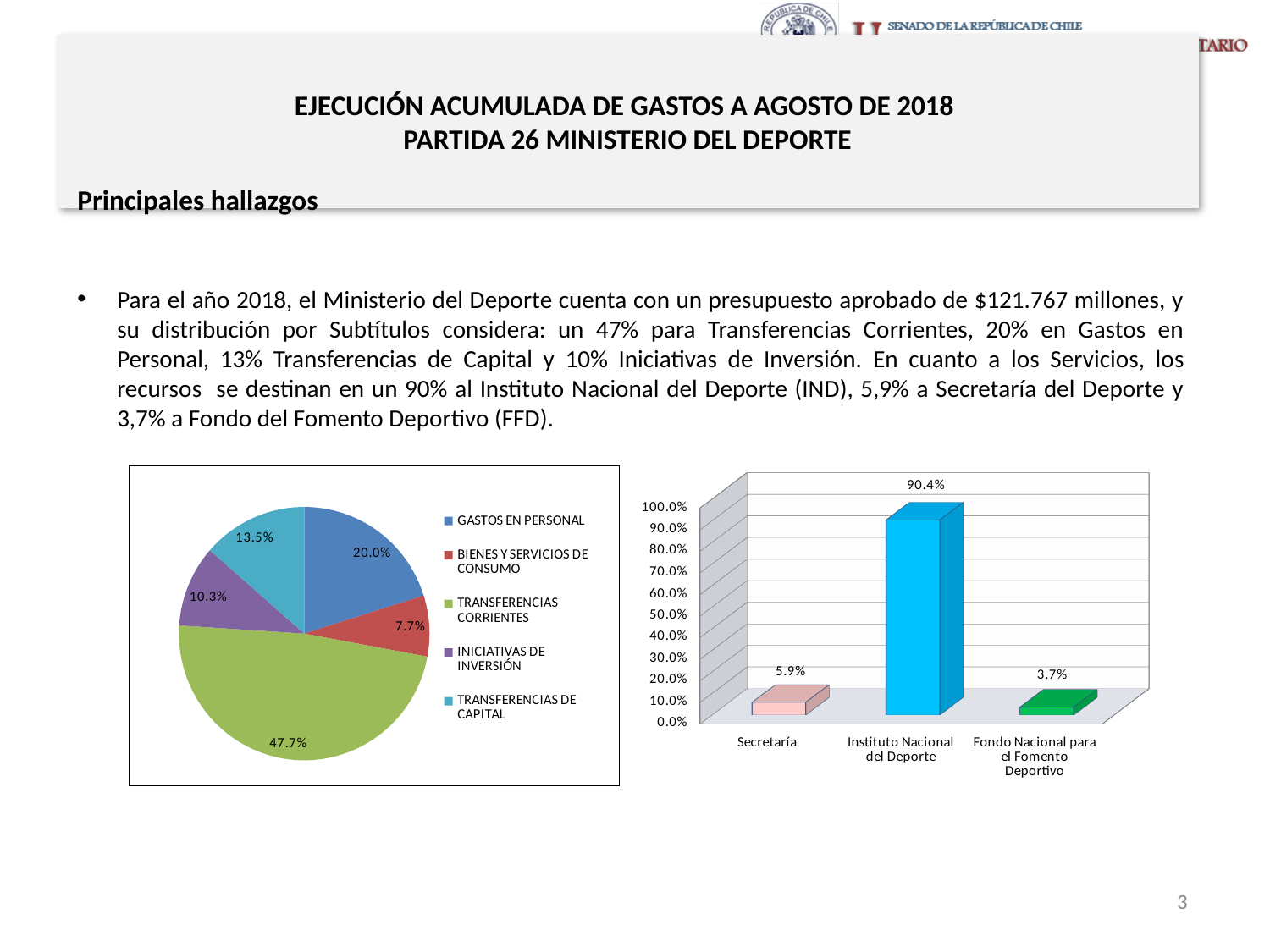
In the pie chart on the left, how many categories does the legend list? 5 In the pie chart on the left, which category has the smallest slice? BIENES Y SERVICIOS DE CONSUMO In the pie chart on the left, what share does TRANSFERENCIAS CORRIENTES have? 47.7% In the bar chart on the right, what is the difference between Instituto Nacional del Deporte and Secretaría? 84.5% In the pie chart on the left, which category has the largest slice? TRANSFERENCIAS CORRIENTES In the bar chart on the right, which category has the lowest value? Fondo Nacional para el Fomento Deportivo In the pie chart on the left, what is the difference between TRANSFERENCIAS DE CAPITAL and INICIATIVAS DE INVERSIÓN? 3.2% In the pie chart on the left, what is the value for GASTOS EN PERSONAL? 20.0% In the bar chart on the right, what is the value for Instituto Nacional del Deporte? 90.4% What type of chart is shown on the right side of the slide? Bar chart In the pie chart on the left, which is larger: INICIATIVAS DE INVERSIÓN or BIENES Y SERVICIOS DE CONSUMO? INICIATIVAS DE INVERSIÓN In the bar chart on the right, what is the value for Secretaría? 5.9%